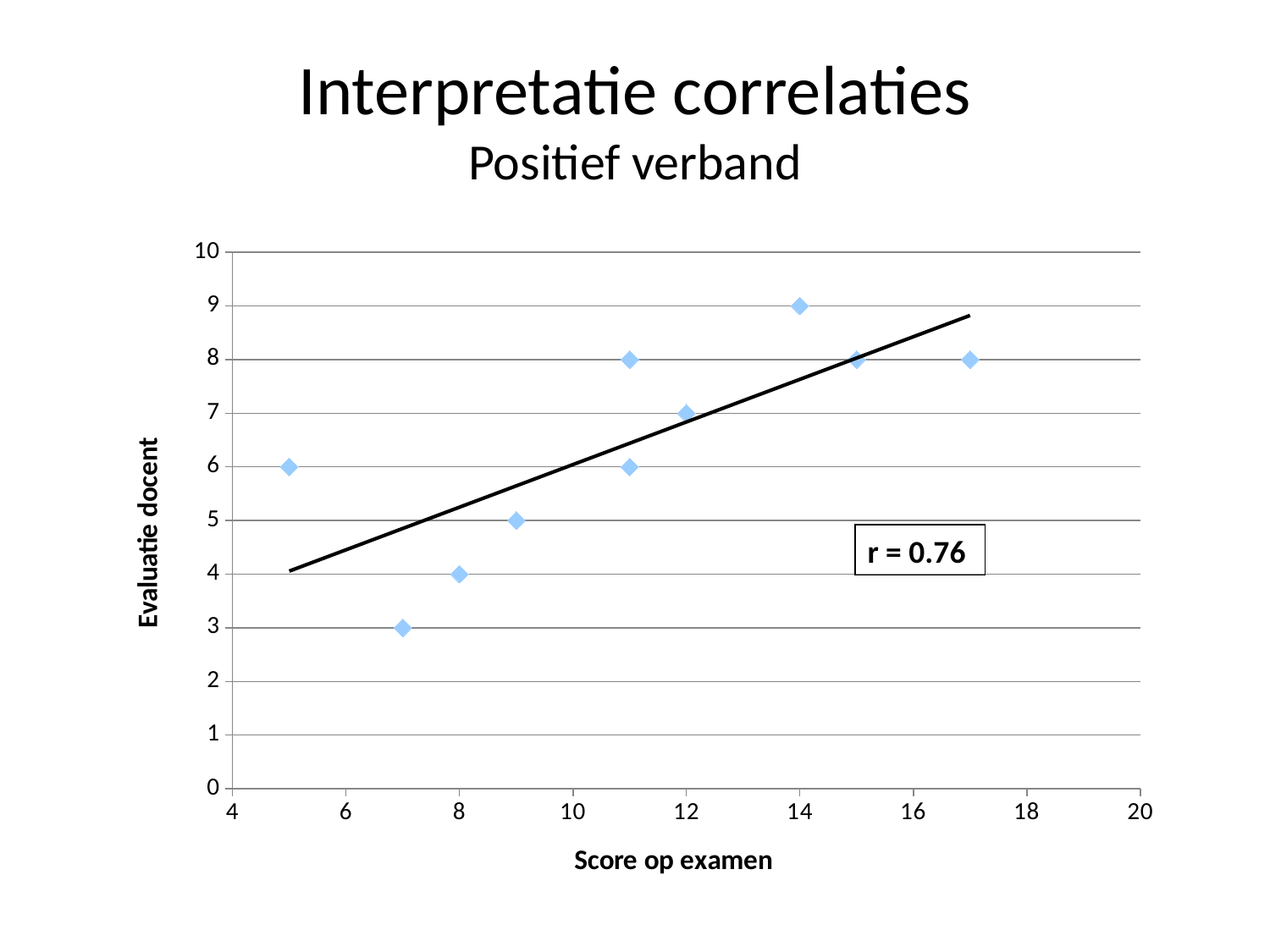
What correlation coefficient is shown in the box on the chart? r = 0.76 How many data points are plotted in the chart? 10 What is the Evaluatie docent value for the point at Score op examen 8? 4 What is the title of the x axis of the chart? Score op examen Which has the larger Evaluatie docent value: the point at Score op examen 8 or the point at Score op examen 12? Score op examen 12 What is the lowest Evaluatie docent value plotted in the chart? 3 Do the Evaluatie docent values generally rise or fall as Score op examen increases? rise What is the highest Evaluatie docent value plotted in the chart? 9 What is the Evaluatie docent value for the point at Score op examen 12? 7 What is the difference in Evaluatie docent between the point at Score op examen 14 and the point at Score op examen 8? 5 What kind of chart is shown on the slide? scatter plot What is the Evaluatie docent value for the point at Score op examen 14? 9